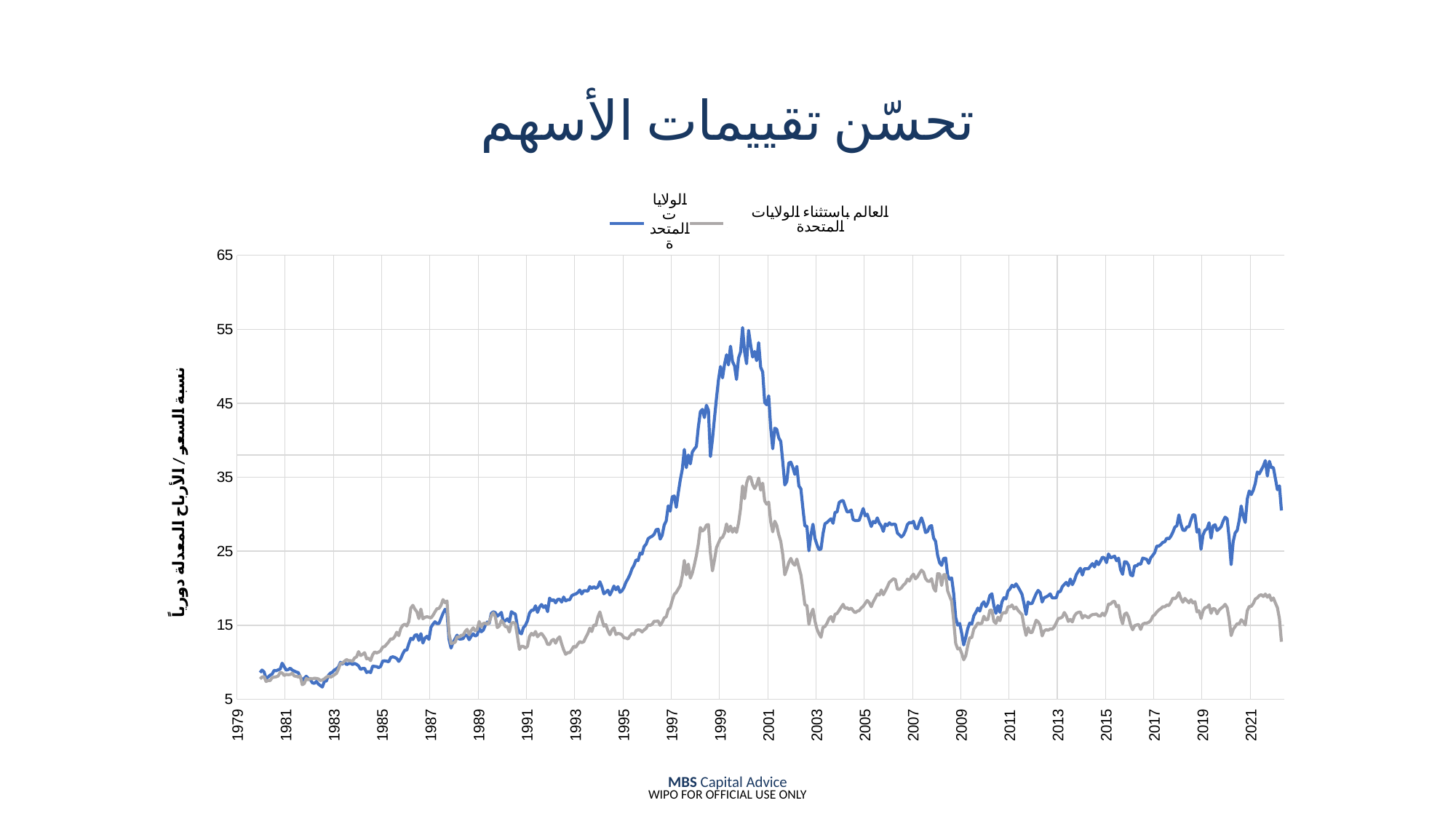
Does the الولايات المتحدة line rise or fall between 2000 and 2003? fall Is the peak value of the العالم باستثناء الولايات المتحدة line around the year 2000 greater or less than 25? greater Does the الولايات المتحدة line rise or fall between 1995 and 2000? rise Is the value of the العالم باستثناء الولايات المتحدة line around 2021 greater or less than 25? less Is the peak value of the الولايات المتحدة line around the year 2000 greater or less than 45? greater What kind of chart is shown on the slide? line chart What colour is the line for الولايات المتحدة? blue What is the title of the chart? تحسّن تقييمات الأسهم How many series does the legend list? 2 Around the year 2000, which series has the higher value: الولايات المتحدة or العالم باستثناء الولايات المتحدة? الولايات المتحدة Around 2015, which series has the higher value: الولايات المتحدة or العالم باستثناء الولايات المتحدة? الولايات المتحدة